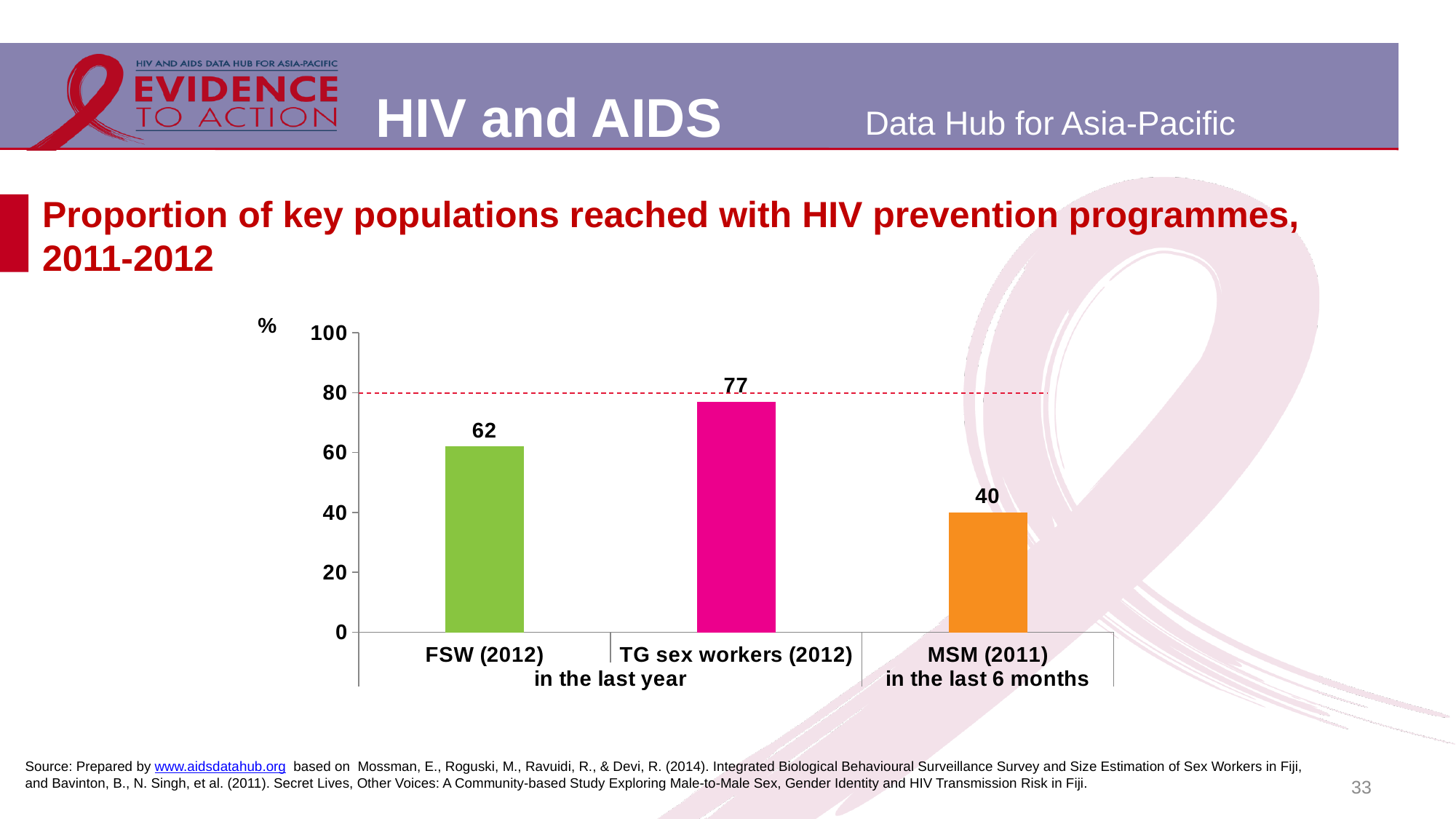
Which category has the lowest value? MSM (2011) What is the value for FSW (2012)? 62 Which category has the highest value? TG sex workers (2012) What is the value for TG sex workers (2012)? 77 What is the value for MSM (2011)? 40 What kind of chart is shown on the slide? bar chart What is the difference between the values for TG sex workers (2012) and FSW (2012)? 15 What unit is shown on the vertical axis of the chart? % What is the difference between the values for FSW (2012) and MSM (2011)? 22 Which is larger, the value for FSW (2012) or the value for MSM (2011)? FSW (2012) Is the value for TG sex workers (2012) greater or less than 80? less How many categories are shown in the chart? 3